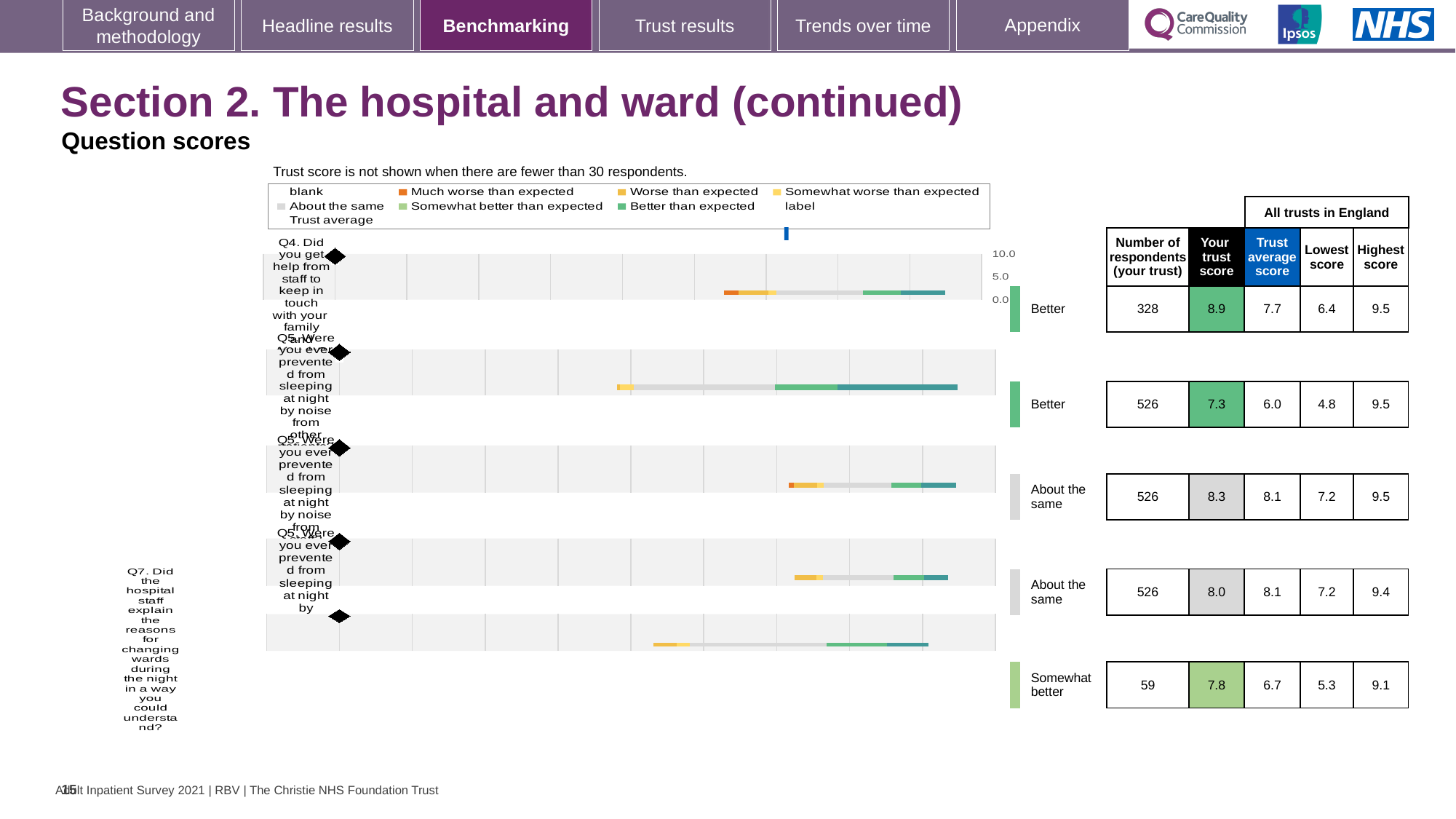
What is the 'Your trust score' for the second question row from the top? 7.3 How many respondents (your trust) are shown for Q7? 59 What kind of chart is used to show the question scores on this slide? Bar chart Which question row has the highest 'Your trust score'? Q4 Which has the larger 'Your trust score', Q4 or Q7? Q4 What is the difference between the 'Your trust score' and the 'Trust average score' for Q4? 1.2 How many question rows are plotted in the chart? 5 What benchmark category is shown for Q4? Better What is the 'Your trust score' for Q7 (hospital staff explaining reasons for changing wards during the night)? 7.8 What is the 'Your trust score' for Q4 (help from staff to keep in touch with family)? 8.9 How many respondents (your trust) are shown for Q4? 328